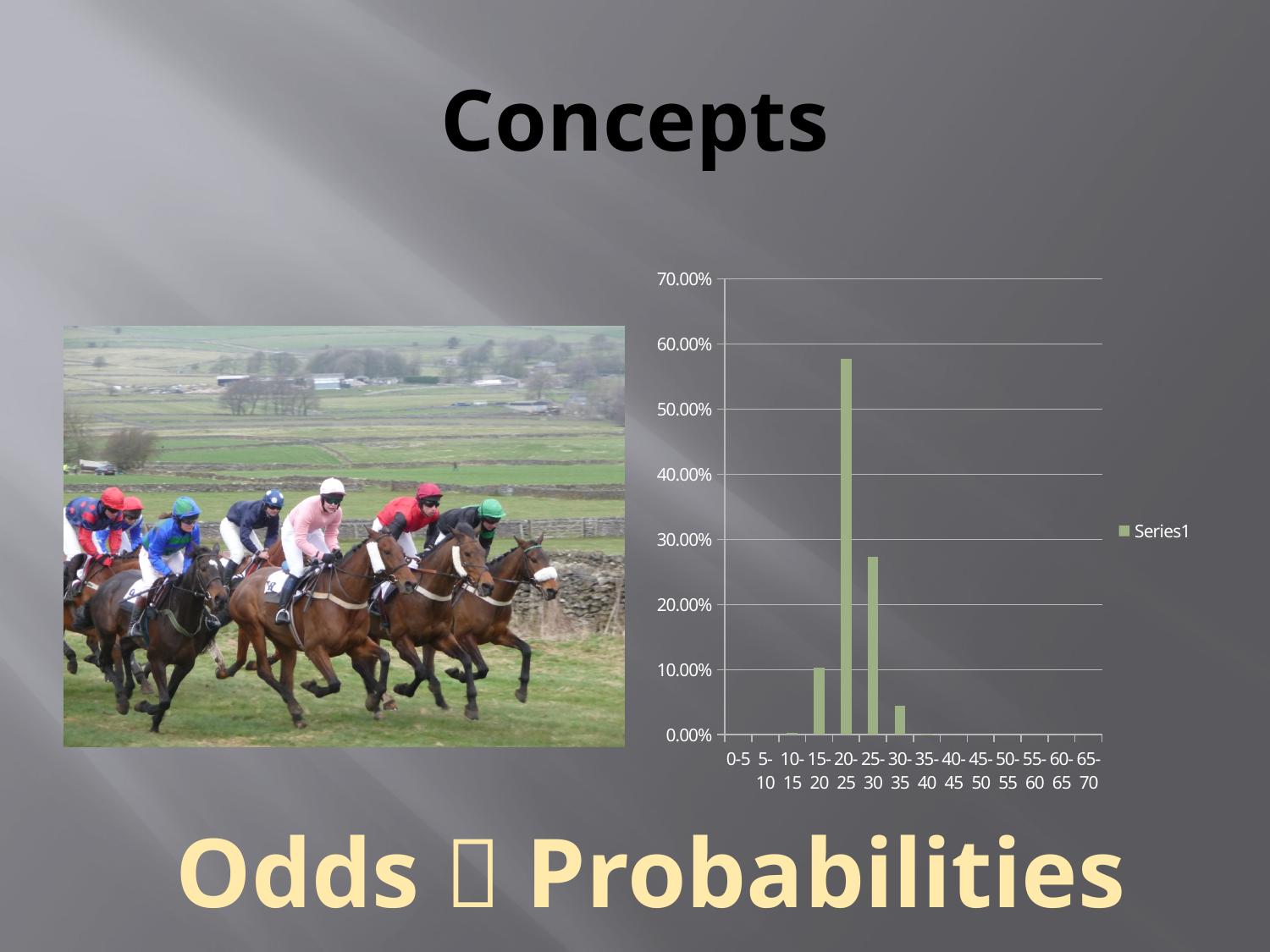
Which is larger, the value for 15-20 or the value for 30-35? 15-20 Is the value for the 20-25 category greater or less than 50.00%? greater What is the name of the series shown in the chart legend? Series1 Which category has the highest bar in the chart? 20-25 Do the values rise or fall along the x axis from the 20-25 category to the 35-40 category? fall Which is larger, the value for 20-25 or the value for 25-30? 20-25 How many categories are shown on the x axis of the chart? 14 Is the value for the 15-20 category greater or less than 20.00%? less How many series does the chart legend list? 1 Is the value for the 25-30 category greater or less than 20.00%? greater What kind of chart is shown on the slide? bar chart